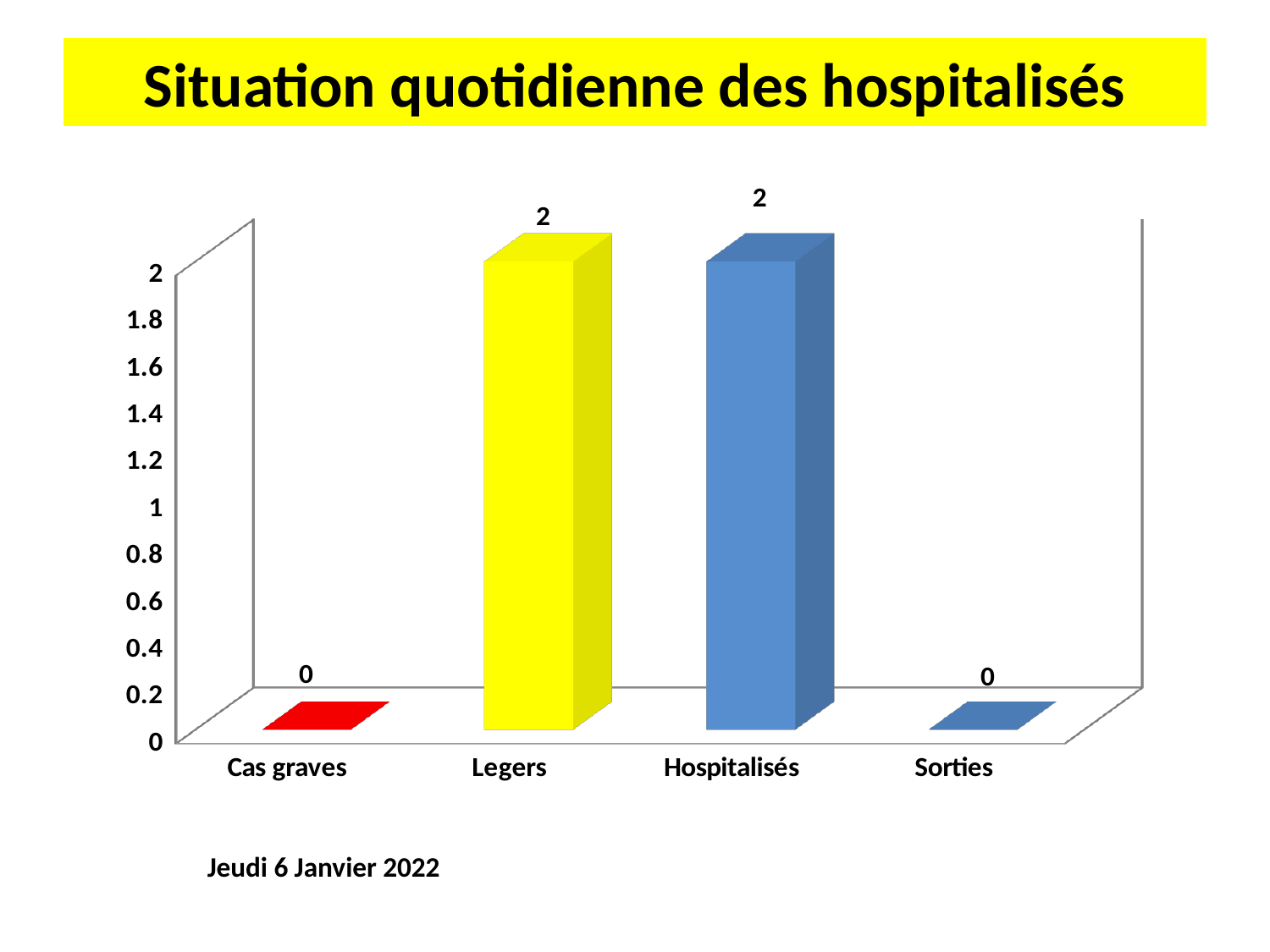
What is the title of the slide? Situation quotidienne des hospitalisés Is the value for Legers greater or less than 1? greater What is the difference between the values for Legers and Cas graves? 2 What is the value for Sorties? 0 What is the highest value shown on the y axis? 2 What is the value for Legers? 2 What colour is the bar for Legers? yellow Which is larger, the value for Hospitalisés or the value for Sorties? Hospitalisés What is the value for Hospitalisés? 2 How many categories are shown on the x axis? 4 What kind of chart is shown on the slide? bar chart What is the value for Cas graves? 0